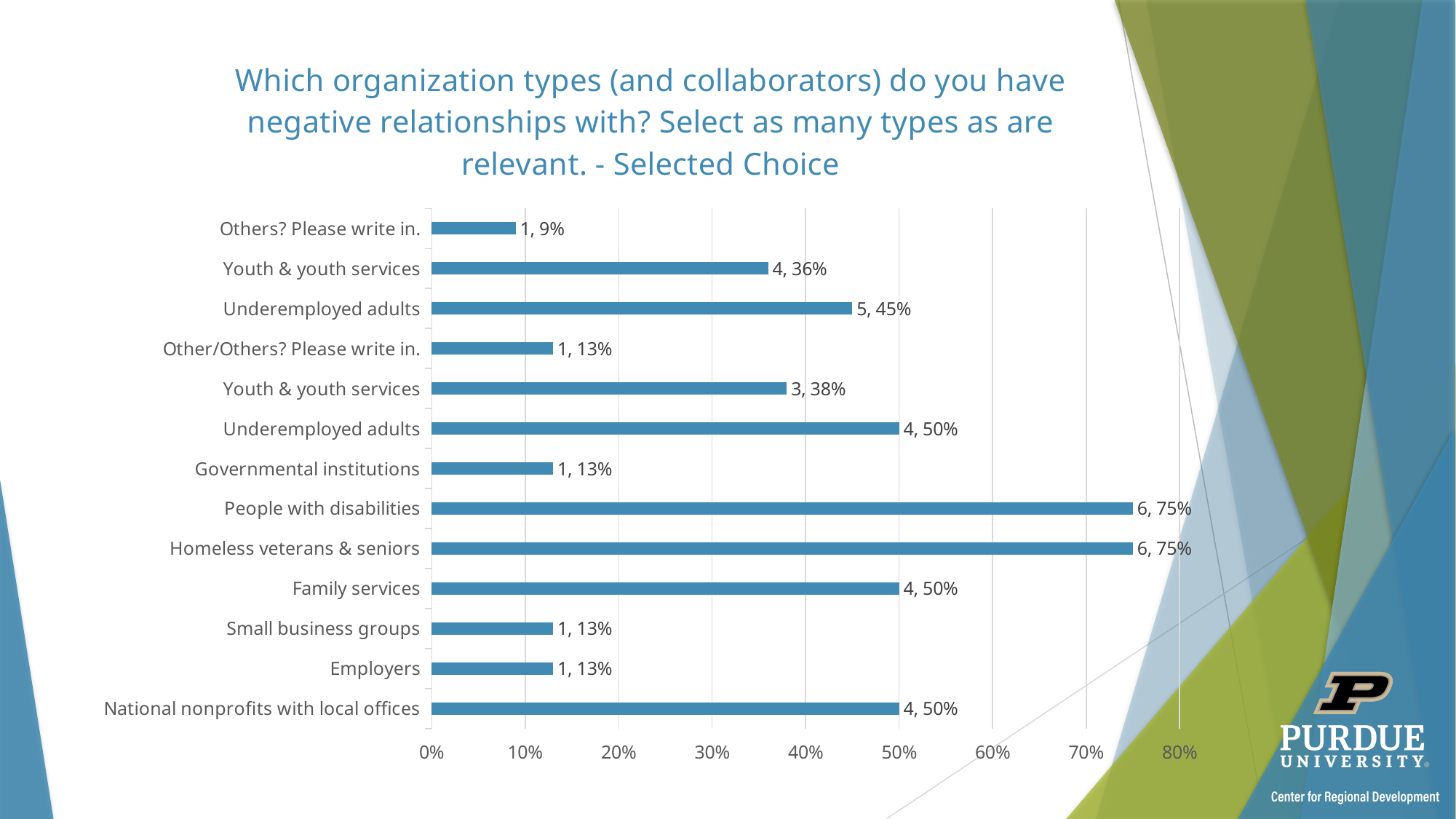
What is the data label shown for People with disabilities? 6, 75% Which category has the lowest percentage? Others? Please write in. Is the value for People with disabilities greater or less than 70%? greater What percentage is shown for Family services? 50% Which two categories share the highest percentage of 75%? People with disabilities and Homeless veterans & seniors What is the highest tick value shown on the horizontal axis? 80% How many bars (categories) does the chart show? 13 What is the data label shown for National nonprofits with local offices? 4, 50% Which has a larger percentage, Family services or Small business groups? Family services What kind of chart is shown on the slide? bar chart What percentage is shown for Governmental institutions? 13% What is the difference in percentage points between Homeless veterans & seniors and Employers? 62